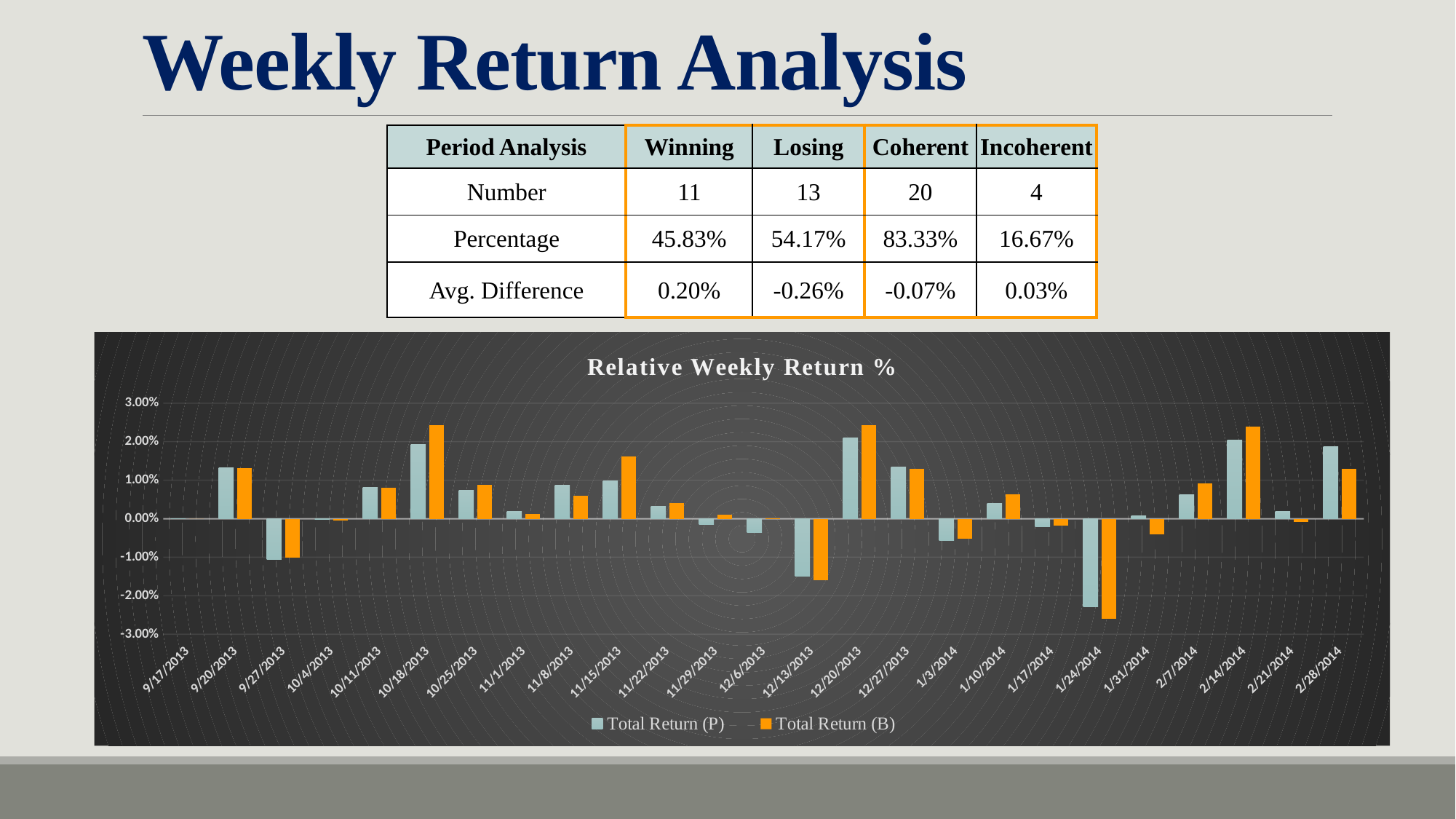
On which date does Total Return (B) reach its lowest value? 1/24/2014 What type of chart is shown on the slide? Bar chart On 11/15/2013, which series has the larger value, Total Return (P) or Total Return (B)? Total Return (B) Which series is drawn in orange in the chart? Total Return (B) Is the value of Total Return (P) on 12/13/2013 greater or less than -1.00%? less Is the value of Total Return (B) on 1/24/2014 greater or less than -2.00%? less What is the title of the chart on the slide? Relative Weekly Return % Is the value of Total Return (B) on 10/18/2013 greater or less than 2.00%? greater On which date does Total Return (P) reach its lowest value? 1/24/2014 How many series does the chart's legend list? 2 On 2/28/2014, which series has the larger value, Total Return (P) or Total Return (B)? Total Return (P) How many dates are shown along the x axis of the chart? 25